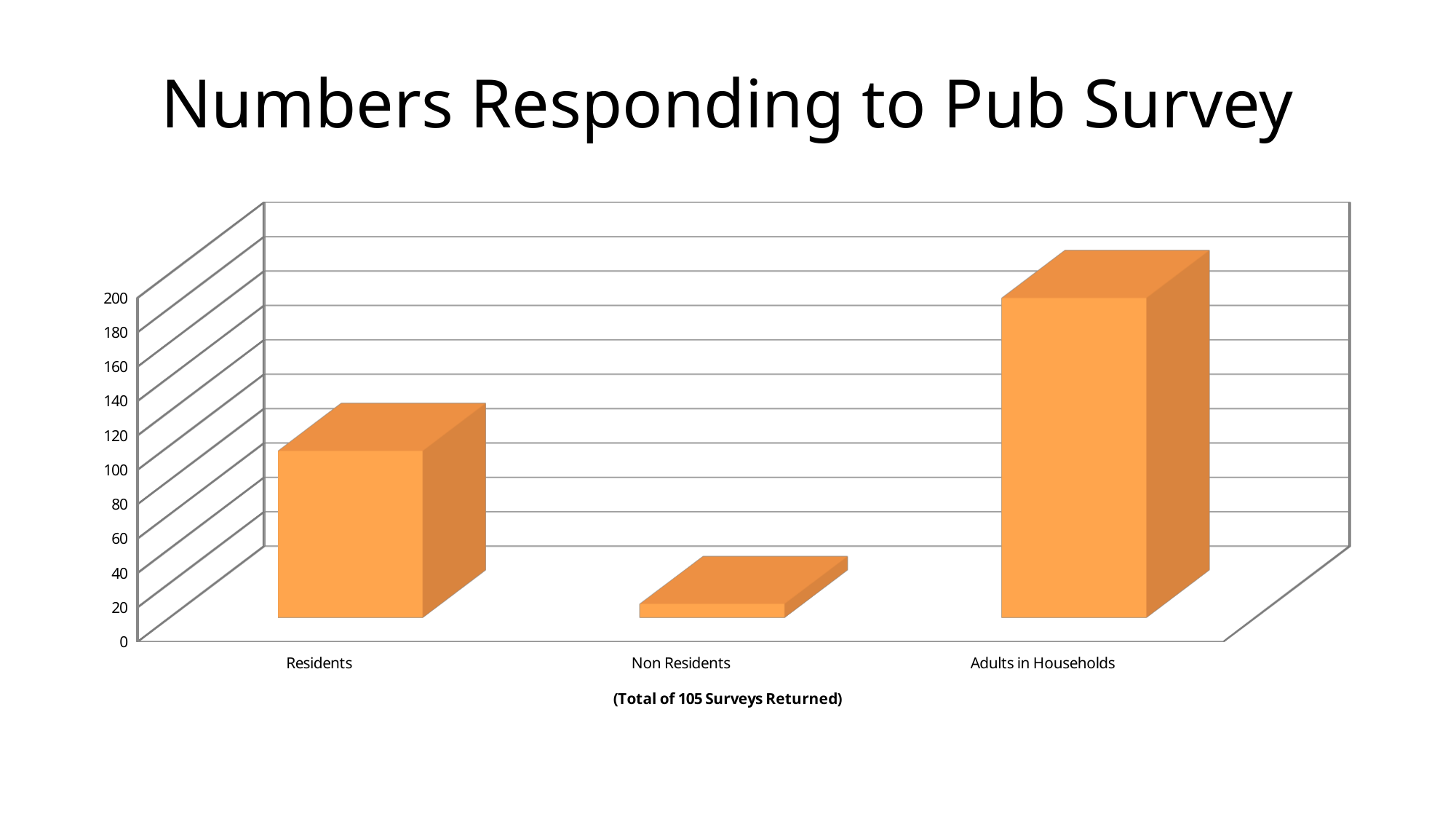
Which is larger, the value for Adults in Households or the value for Residents? Adults in Households Is the value for Residents greater or less than 160? less Which category has the highest value? Adults in Households Is the value for Adults in Households greater or less than 140? greater Is the value for Residents greater or less than 60? greater How many categories are shown on the x axis? 3 What is the title of the chart? Numbers Responding to Pub Survey Which is larger, the value for Residents or the value for Non Residents? Residents According to the note below the x axis, how many surveys were returned in total? 105 Which category has the lowest value? Non Residents What kind of chart is shown on the slide? bar chart